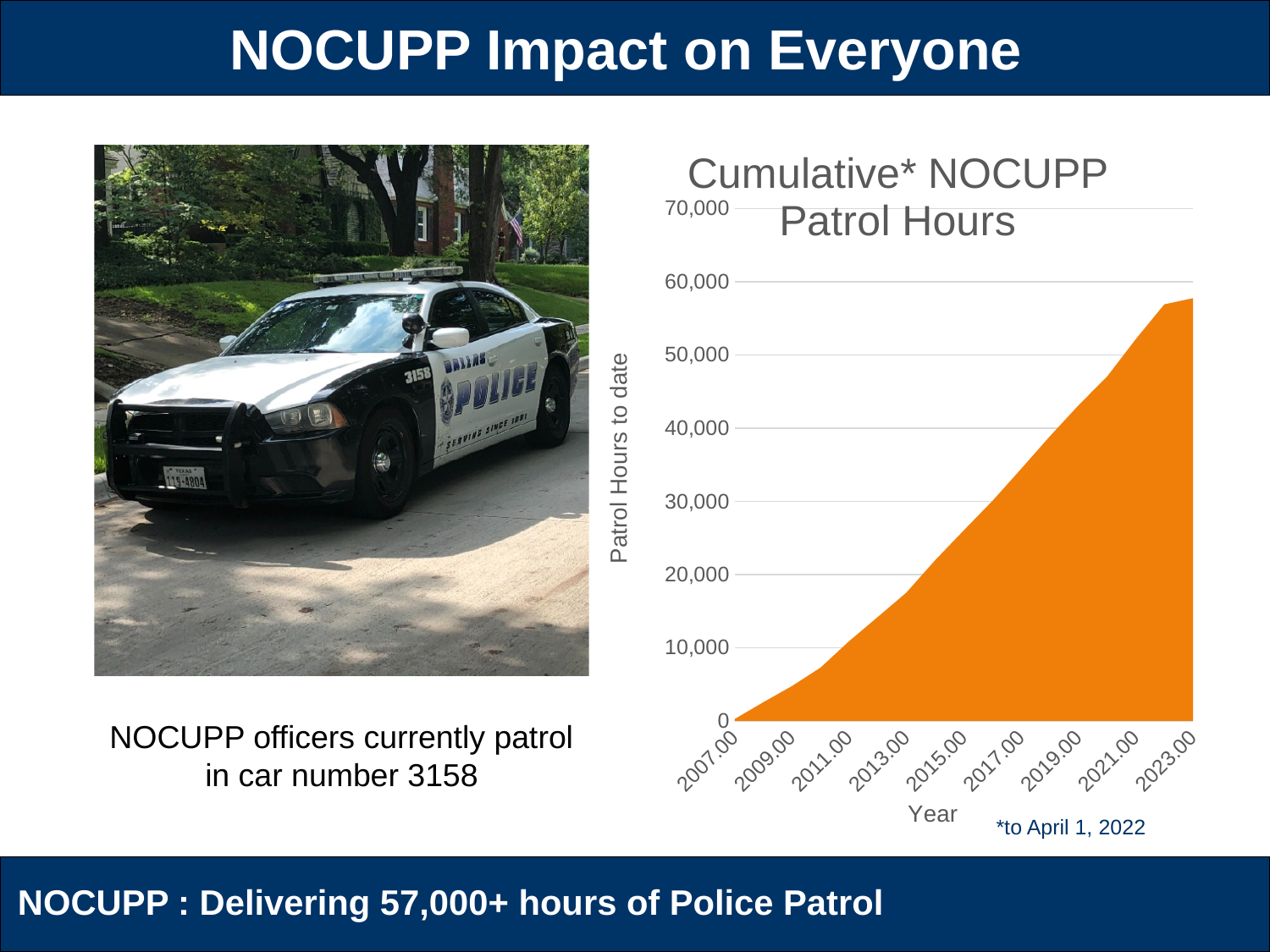
Is the final value of cumulative patrol hours at the right end of the chart greater or less than 60,000? less Is the value of cumulative patrol hours at 2013.00 greater or less than 10,000? greater Which year label on the x axis corresponds to the lowest cumulative patrol hours? 2007.00 Is the final value of cumulative patrol hours at the right end of the chart greater or less than 50,000? greater Which is larger, the cumulative patrol hours at 2015.00 or at 2021.00? 2021.00 How many year labels are shown on the x axis of the chart? 9 What kind of chart is shown on the slide? Area chart What is the title of the chart? Cumulative* NOCUPP Patrol Hours What is the label of the vertical axis of the chart? Patrol Hours to date Do the cumulative patrol hours rise or fall from 2007 to 2023 along the x axis? Rise